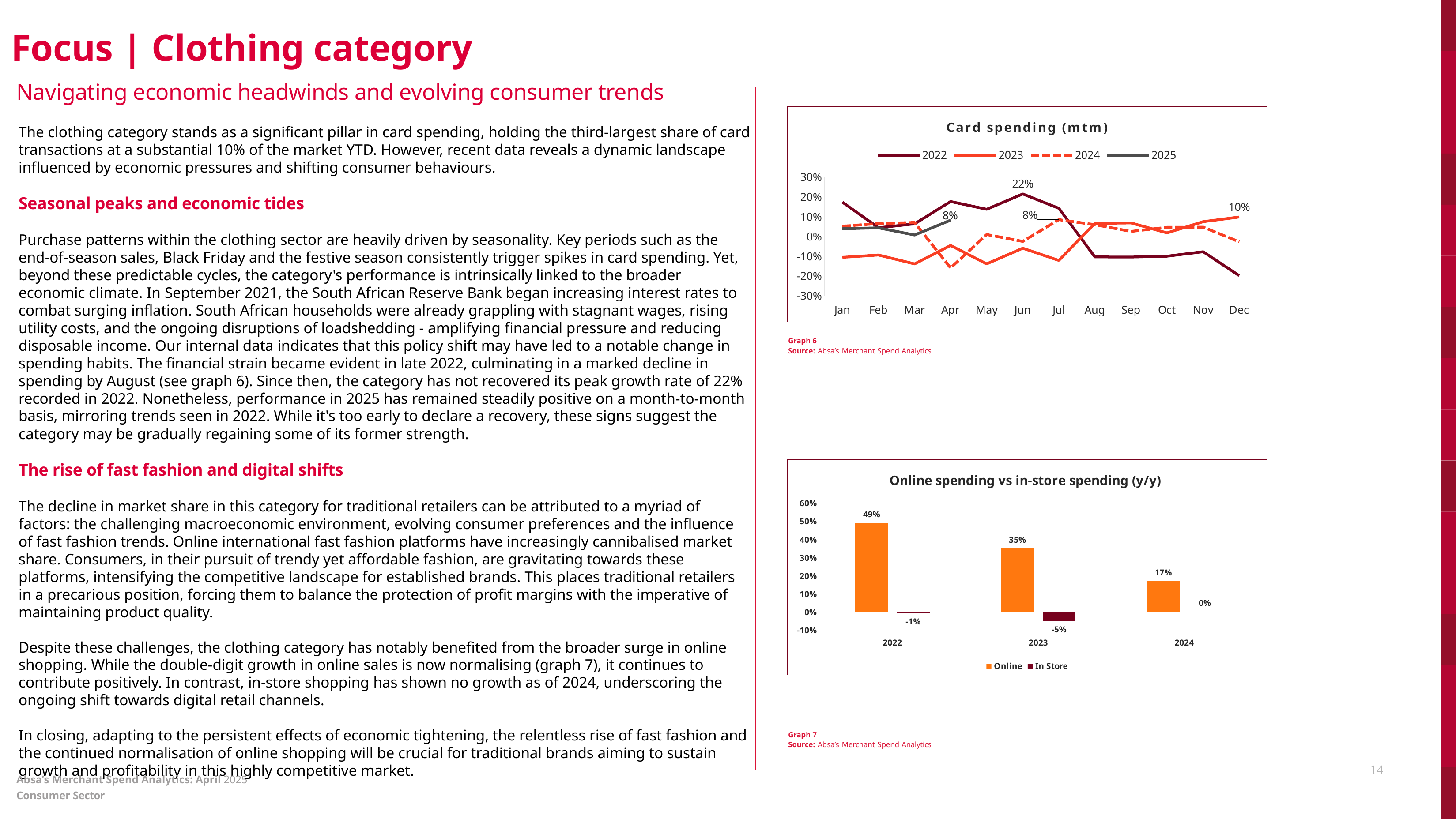
In the 'Card spending (mtm)' chart, what type of chart is shown? Line chart In the 'Card spending (mtm)' chart, what is the labelled value for 2025 in April? 8% In the 'Card spending (mtm)' chart, what is the labelled value for 2022 in June? 22% In the 'Card spending (mtm)' chart, what is the labelled value for 2023 in December? 10% In the 'Online spending vs in-store spending (y/y)' chart, what is the difference between the Online values for 2022 and 2024? 32% In the 'Online spending vs in-store spending (y/y)' chart, which year has the highest Online value? 2022 In the 'Online spending vs in-store spending (y/y)' chart, what is the Online value for 2023? 35% In the 'Card spending (mtm)' chart, how many months are shown on the x axis? 12 In the 'Online spending vs in-store spending (y/y)' chart, what type of chart is shown? Bar chart In the 'Card spending (mtm)' chart, is the value for 2022 in December greater or less than -10%? less In the 'Online spending vs in-store spending (y/y)' chart, what is the In Store value for 2023? -5% In the 'Card spending (mtm)' chart, how many series does the legend list? 4